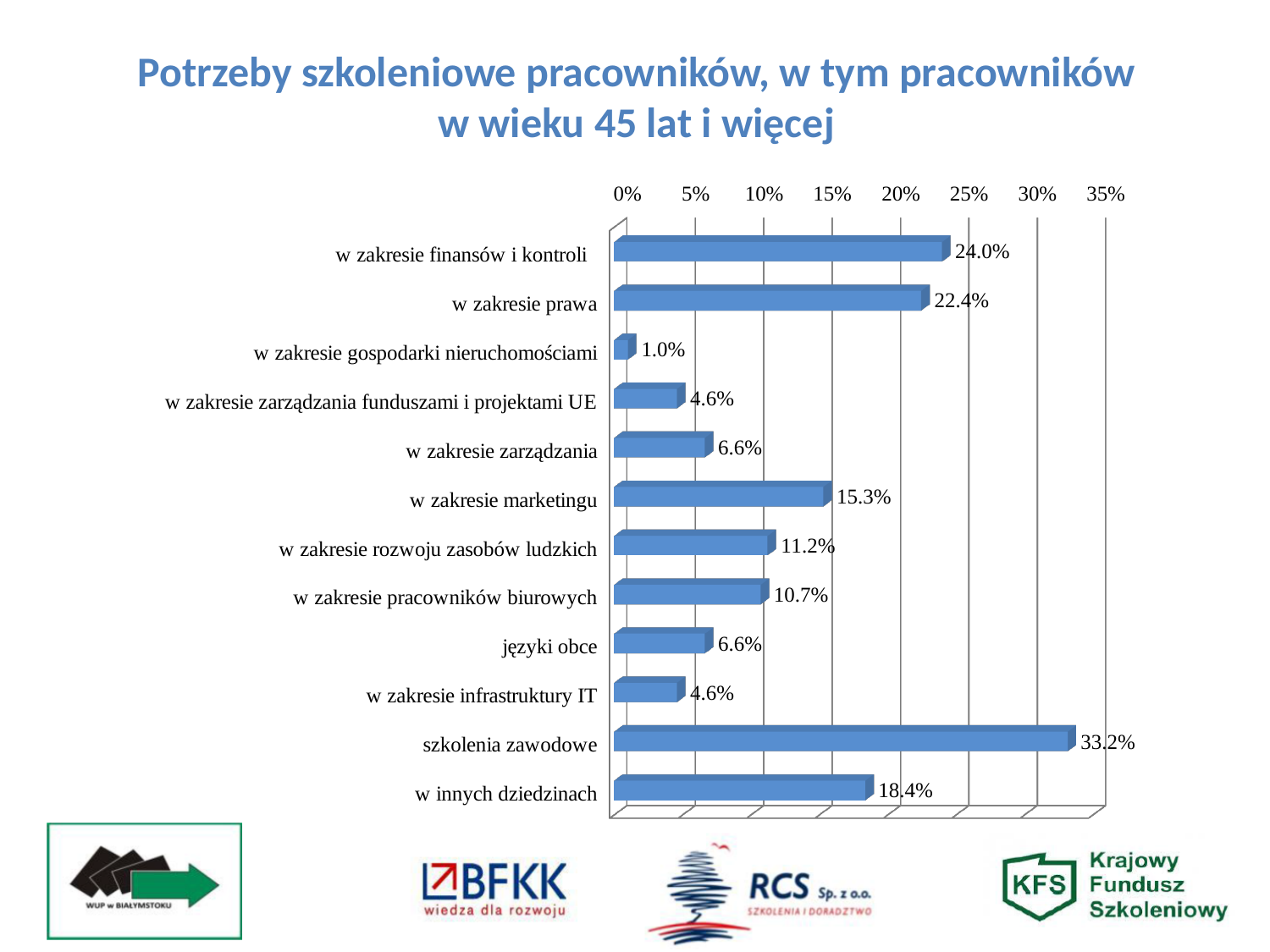
What is the difference between the values for "szkolenia zawodowe" and "w zakresie finansów i kontroli"? 9.2% What is the difference between the values for "w zakresie rozwoju zasobów ludzkich" and "w zakresie pracowników biurowych"? 0.5% What is the value for "w innych dziedzinach"? 18.4% Which category has the highest value? szkolenia zawodowe What kind of chart is shown on the slide? bar chart Which is larger, the value for "w zakresie finansów i kontroli" or the value for "w zakresie prawa"? w zakresie finansów i kontroli How many categories are shown in the chart? 12 What is the value for "szkolenia zawodowe"? 33.2% What is the value for "w zakresie prawa"? 22.4% Which category has the lowest value? w zakresie gospodarki nieruchomościami Is the value for "w innych dziedzinach" greater or less than 20%? less What is the value for "w zakresie marketingu"? 15.3%